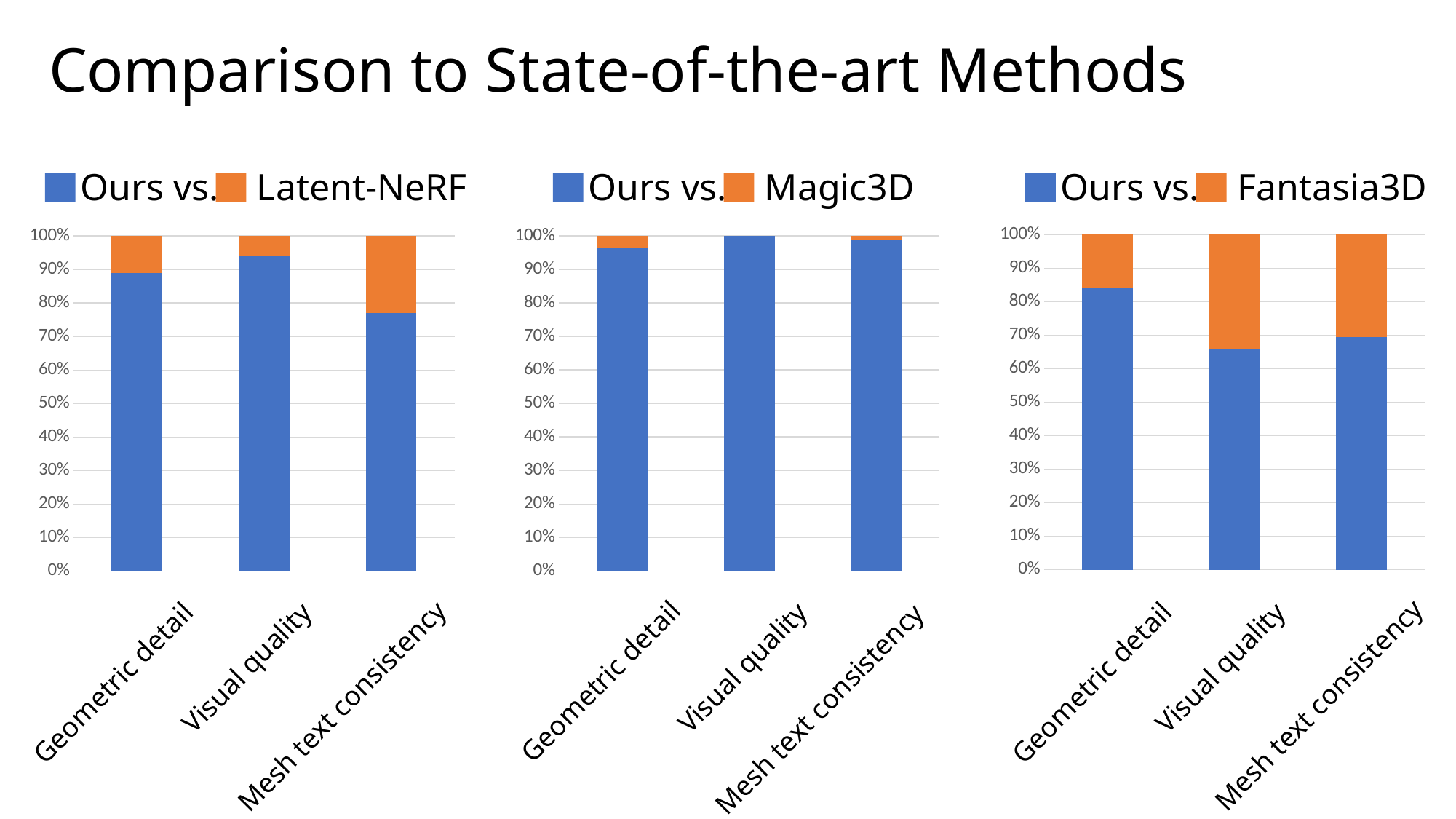
What kind of chart is the 'Ours vs. Latent-NeRF' chart on the left? Stacked bar chart How many series does the legend of the 'Ours vs. Fantasia3D' chart on the right list? 2 In the 'Ours vs. Fantasia3D' chart on the right, which category has the highest value for the 'Ours vs.' series? Geometric detail In the 'Ours vs. Latent-NeRF' chart on the left, which category has the lowest value for the 'Ours vs.' series? Mesh text consistency In the 'Ours vs. Latent-NeRF' chart on the left, which is larger for the 'Ours vs.' series: Geometric detail or Mesh text consistency? Geometric detail In the 'Ours vs. Fantasia3D' chart on the right, is the 'Ours vs.' value for Visual quality greater or less than 70%? less In the 'Ours vs. Latent-NeRF' chart on the left, which category has the highest value for the 'Ours vs.' series? Visual quality In the 'Ours vs. Magic3D' chart in the middle, what is the value of the 'Ours vs.' series for Visual quality? 100% In the 'Ours vs. Magic3D' chart in the middle, what is the total of the stacked bar for Geometric detail? 100% How many categories are shown on the x axis of the 'Ours vs. Magic3D' chart in the middle? 3 In the 'Ours vs. Latent-NeRF' chart on the left, is the 'Ours vs.' value for Mesh text consistency greater or less than 80%? less In the 'Ours vs. Fantasia3D' chart on the right, is the 'Ours vs.' value for Geometric detail greater or less than 80%? greater